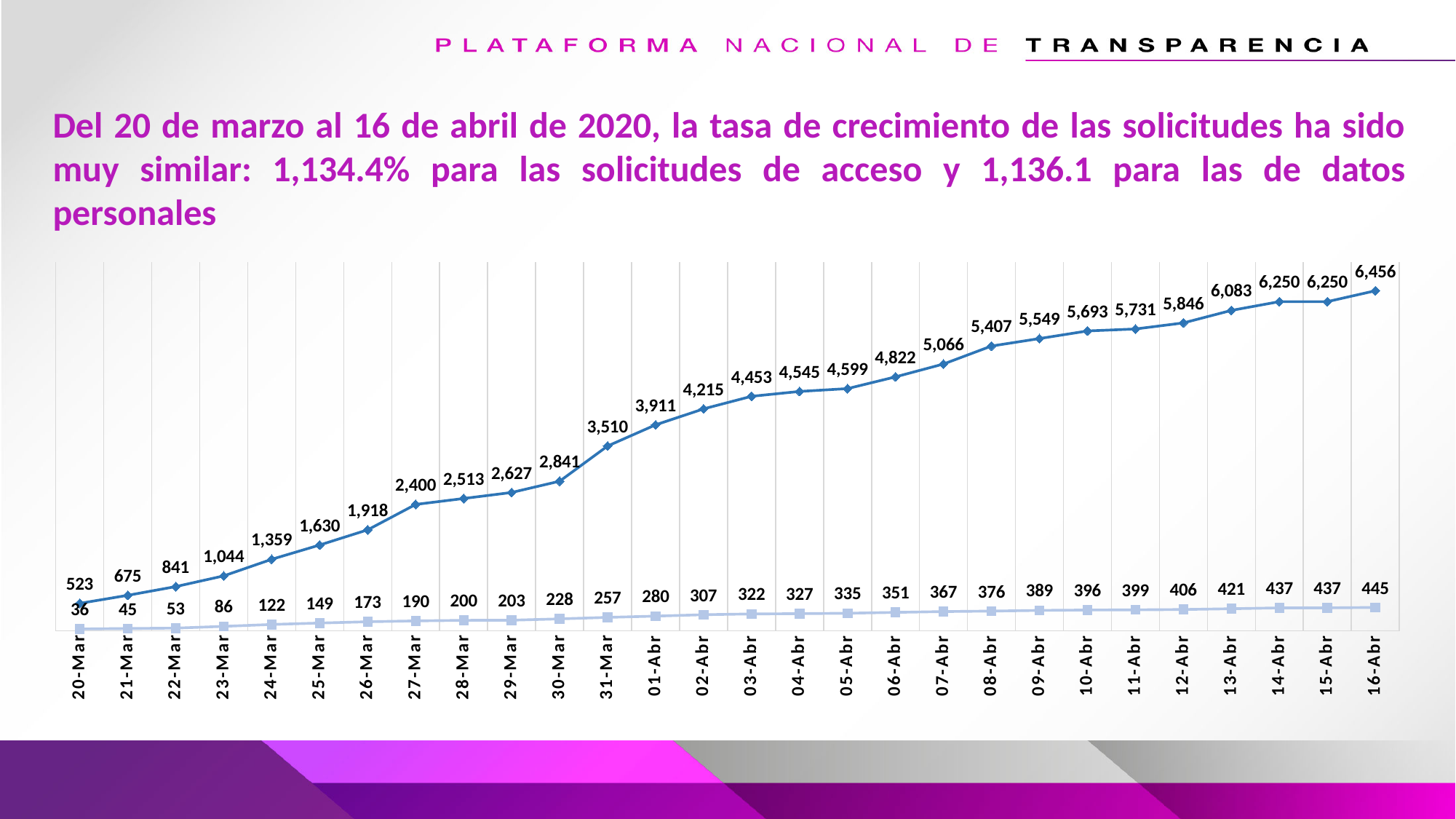
How many data series (lines) are plotted on the chart? 2 What is the value of the lower line on 10-Abr? 396 What is the value of the upper line on 31-Mar? 3,510 What is the difference between the upper line's value on 16-Abr and its value on 20-Mar? 5,933 On which date does the upper line reach its highest value? 16-Abr On which date does the lower line have its lowest value? 20-Mar Do the values of the upper line rise or fall from 20-Mar to 16-Abr? Rise How many dates are shown along the x axis of the chart? 28 Which is larger for the upper line: the value on 13-Abr or the value on 14-Abr? 14-Abr What is the value of the lower line on 20-Mar? 36 What is the value of the upper line on 16-Abr? 6,456 What type of chart is shown on the slide? Line chart